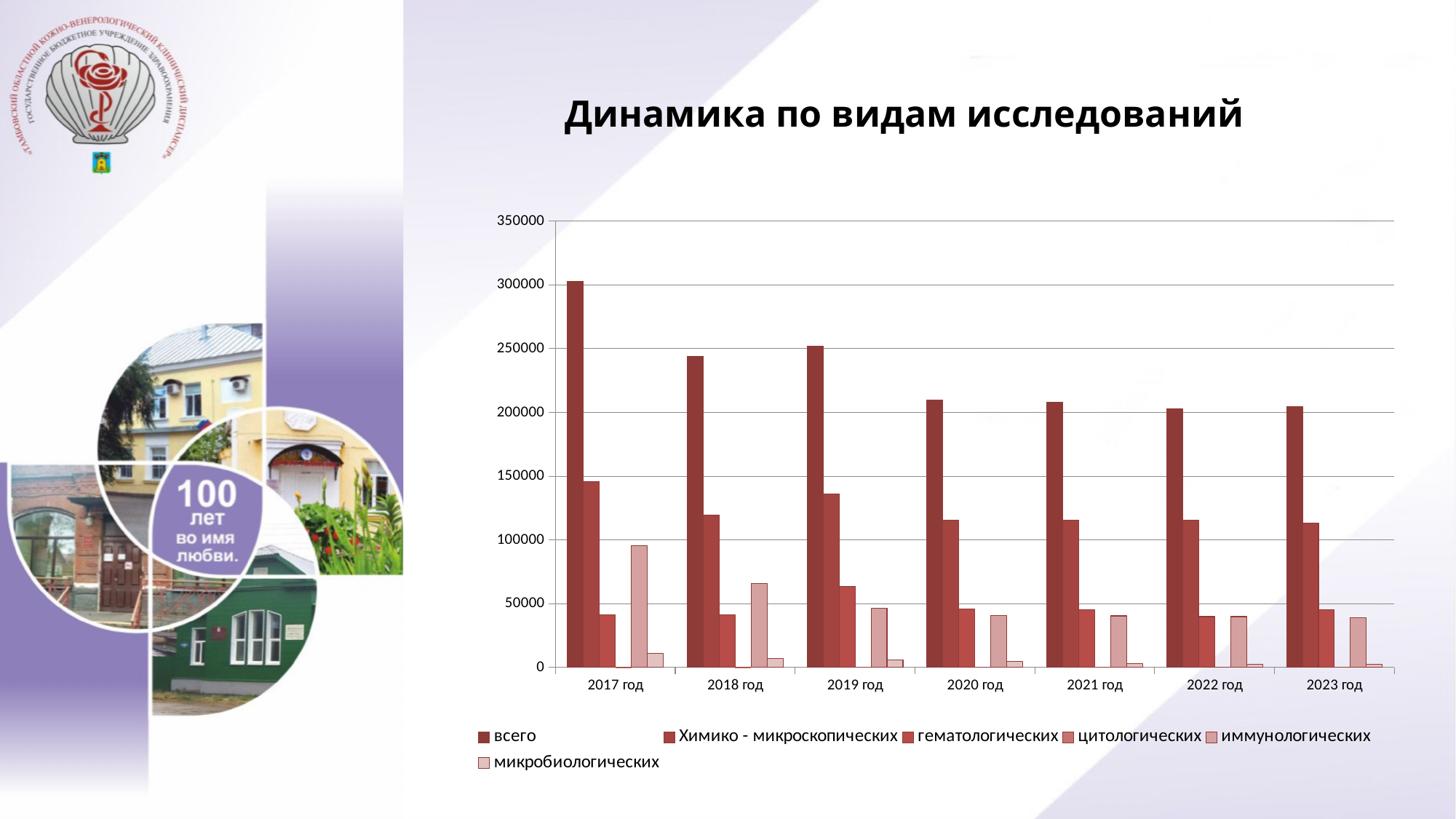
Do the values for микробиологических rise or fall from 2017 год to 2023 год? fall In which year is the value for иммунологических the highest? 2017 год What is the title of the chart? Динамика по видам исследований In which year is the value for всего the highest? 2017 год What kind of chart is shown on the slide? bar chart Is the value for микробиологических in 2017 год greater or less than 50000? less Is the value for Химико - микроскопических in 2017 год greater or less than 100000? greater Is the value for всего in 2017 год greater or less than 250000? greater How many years (categories) are shown on the x axis of the chart? 7 How many series does the chart legend list? 6 Which is larger: the value for всего in 2017 год or in 2018 год? 2017 год